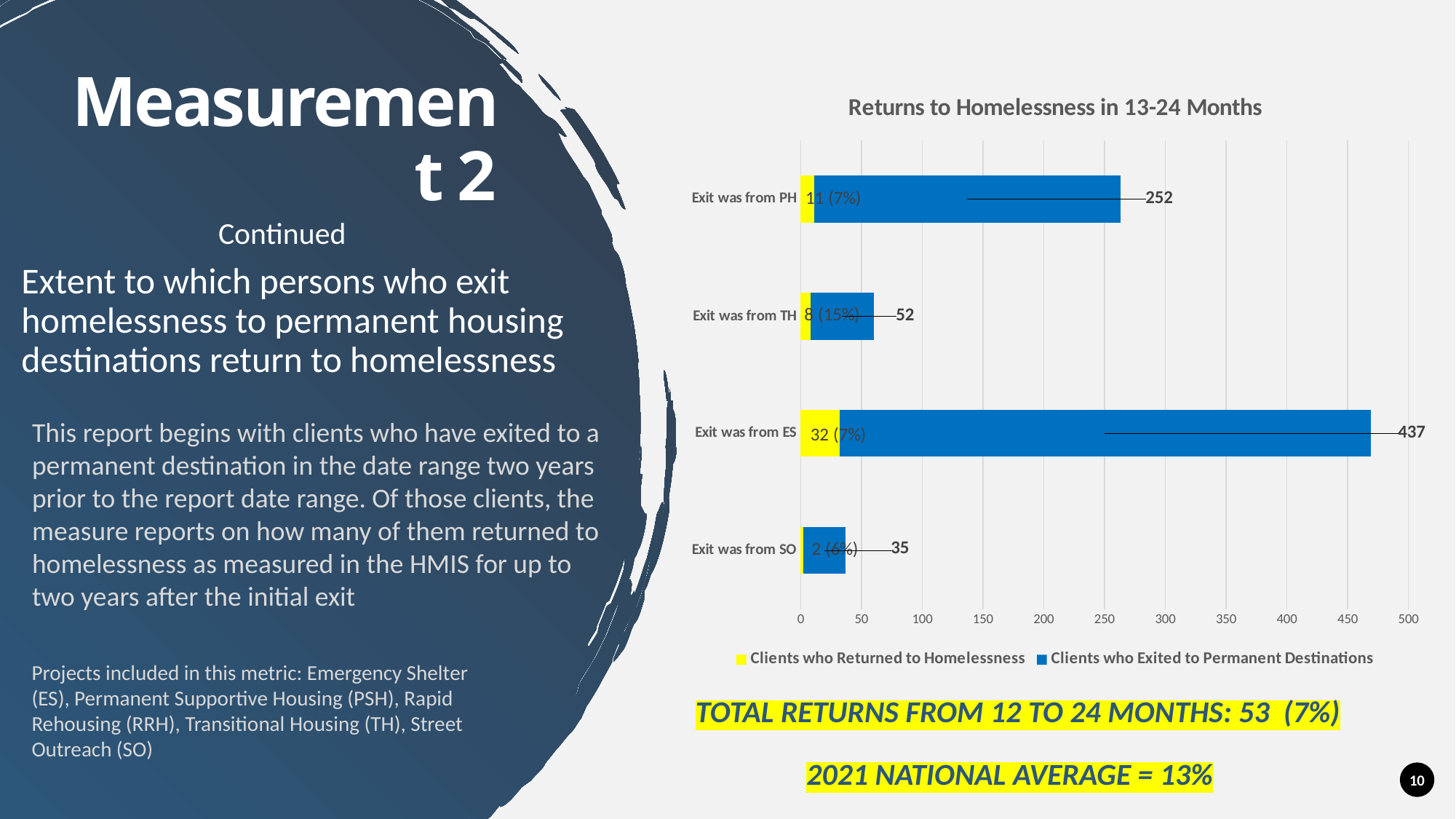
What is the title of the chart? Returns to Homelessness in 13-24 Months Which is larger: the number of clients who exited to permanent destinations from TH or from SO? Exit was from TH What is the data label for clients who returned to homelessness after exiting from SO? 2 (6%) What is the difference between the number of clients who exited to permanent destinations from ES and from PH? 185 How many exit categories are shown in the chart? 4 What kind of chart is shown on the slide? bar chart How many clients who exited from TH exited to permanent destinations? 52 Which exit category has the lowest number of clients who exited to permanent destinations? Exit was from SO Which exit category has the highest number of clients who exited to permanent destinations? Exit was from ES How many series does the chart legend list? 2 What is the data label for clients who returned to homelessness after exiting from PH? 11 (7%) How many clients who exited from ES exited to permanent destinations? 437